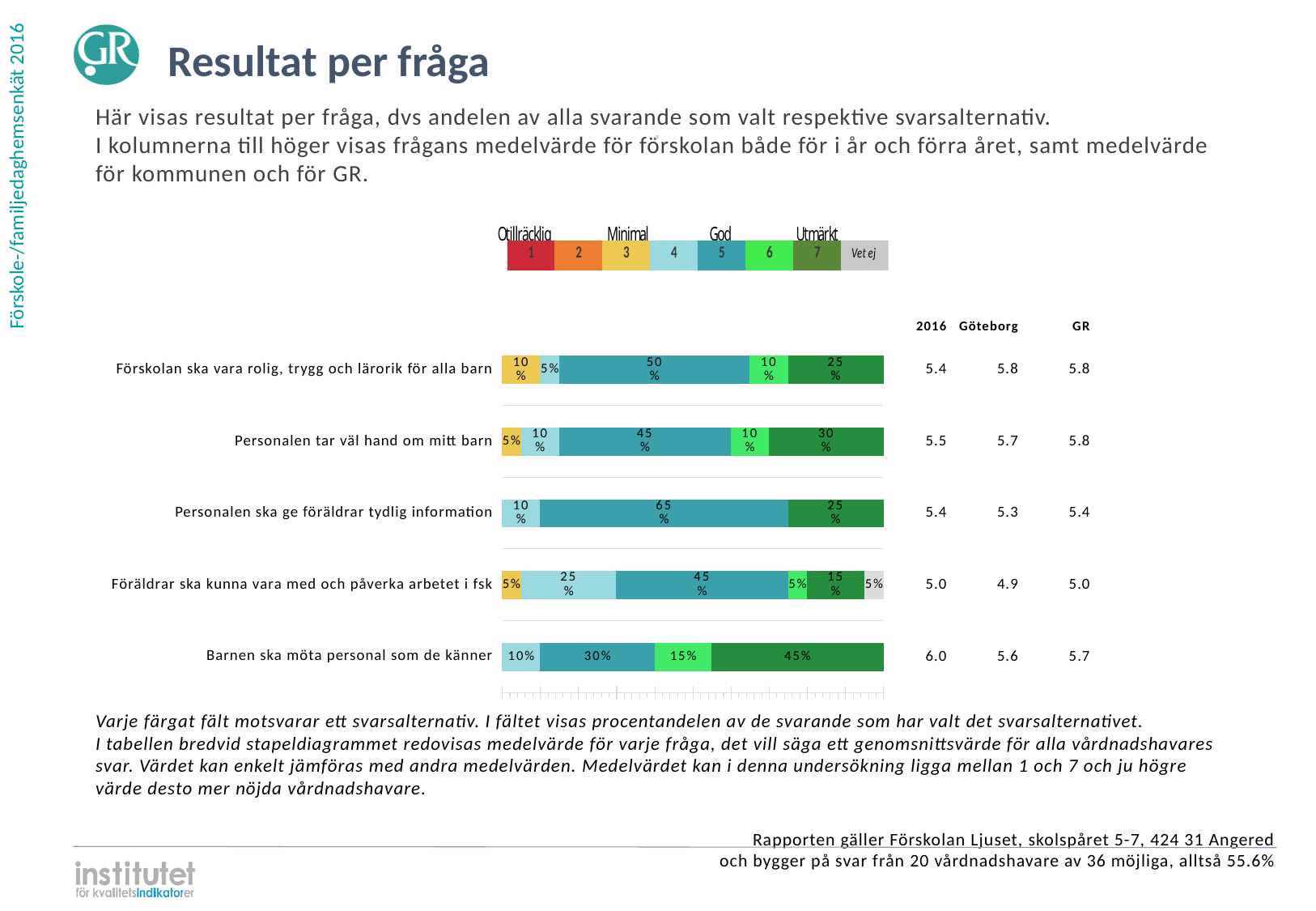
How many questions (categories) are plotted in the bar chart? 5 Which question has the only 'Vet ej' segment in the chart? Föräldrar ska kunna vara med och påverka arbetet i fsk Which question has the largest share of respondents choosing 5 (God)? Personalen ska ge föräldrar tydlig information Which is larger: the 7 (Utmärkt) share for 'Personalen tar väl hand om mitt barn' or for 'Förskolan ska vara rolig, trygg och lärorik för alla barn'? Personalen tar väl hand om mitt barn How many response alternatives does the legend above the chart list? 8 What percentage of respondents chose 7 (Utmärkt) for 'Barnen ska möta personal som de känner'? 45% Which question has the largest share of respondents choosing 7 (Utmärkt)? Barnen ska möta personal som de känner What percentage of respondents chose 4 for 'Föräldrar ska kunna vara med och påverka arbetet i fsk'? 25% What is the difference in percentage points between the 5 (God) share and the 7 (Utmärkt) share for 'Personalen ska ge föräldrar tydlig information'? 40 percentage points What percentage of respondents chose 5 (God) for 'Personalen ska ge föräldrar tydlig information'? 65% What kind of chart is shown on the slide? Stacked bar chart What is the 2016 mean value shown for 'Barnen ska möta personal som de känner'? 6.0